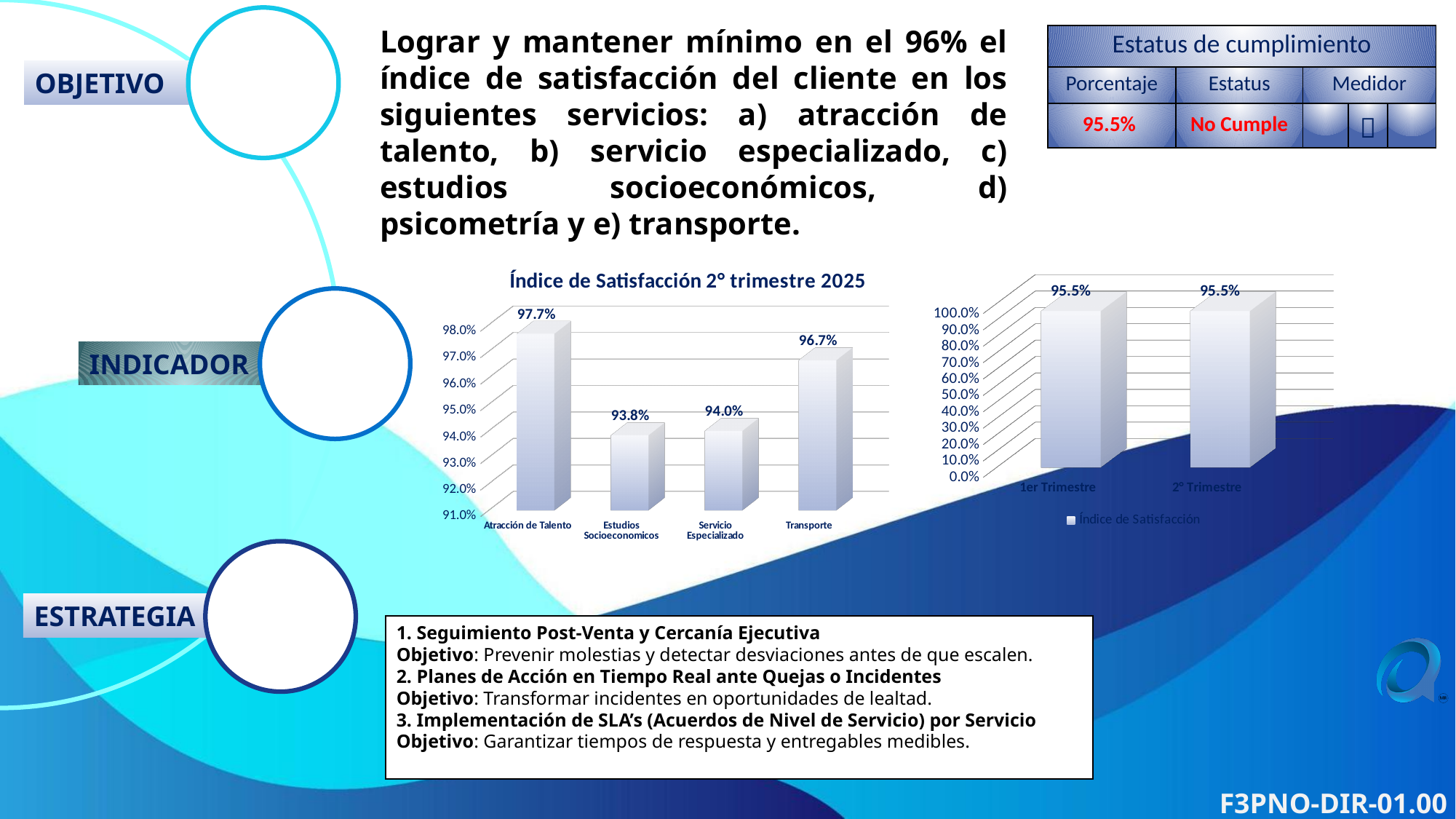
In the chart titled 'Índice de Satisfacción 2° trimestre 2025', which category has the highest value? Atracción de Talento In the chart on the right of the slide, how many series does the legend list? 1 In the chart titled 'Índice de Satisfacción 2° trimestre 2025', which category has the lowest value? Estudios Socioeconomicos In the chart on the right of the slide, what is the legend entry? Índice de Satisfacción What kind of chart is the chart titled 'Índice de Satisfacción 2° trimestre 2025'? Bar chart In the chart on the right of the slide, what is the value for 1er Trimestre? 95.5% In the chart titled 'Índice de Satisfacción 2° trimestre 2025', which is larger, the value for Servicio Especializado or the value for Transporte? Transporte In the chart titled 'Índice de Satisfacción 2° trimestre 2025', how many categories are shown? 4 In the chart titled 'Índice de Satisfacción 2° trimestre 2025', what is the difference between the values for Atracción de Talento and Transporte? 1.0% In the chart titled 'Índice de Satisfacción 2° trimestre 2025', what is the value for Estudios Socioeconomicos? 93.8% In the chart titled 'Índice de Satisfacción 2° trimestre 2025', what is the value for Transporte? 96.7% In the chart titled 'Índice de Satisfacción 2° trimestre 2025', what is the value for Atracción de Talento? 97.7%